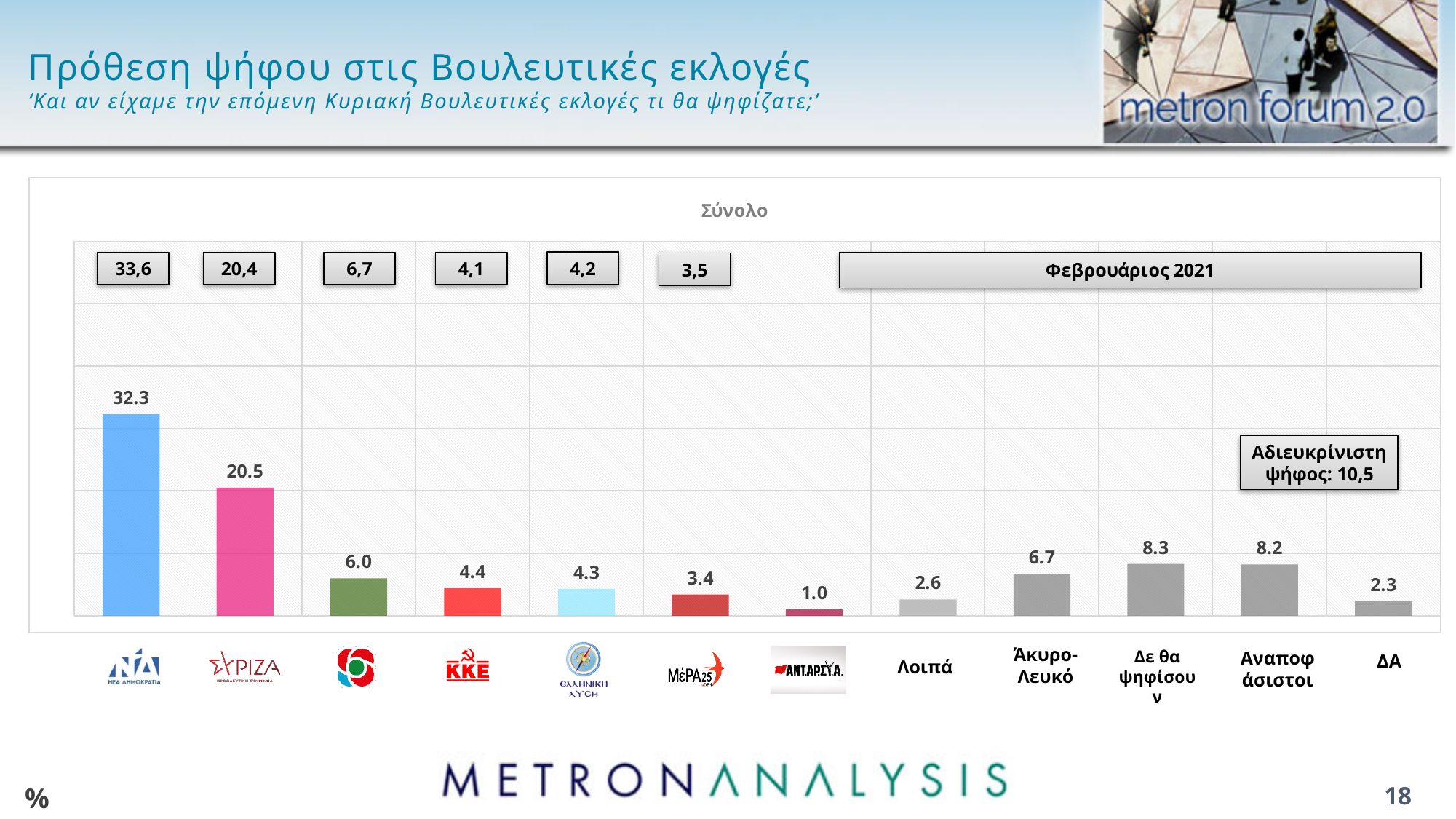
Which category has the lowest value? ΑΝΤΑΡΣΥΑ Which is larger, the value for Άκυρο-Λευκό or the value for Λοιπά? Άκυρο-Λευκό What kind of chart is shown on the slide? Bar chart How many bars are plotted in the chart? 12 What is the Φεβρουάριος 2021 value shown in the box above the ΝΕΑ ΔΗΜΟΚΡΑΤΙΑ bar? 33,6 What is the value for Άκυρο-Λευκό? 6.7 What is the difference between the values for ΝΕΑ ΔΗΜΟΚΡΑΤΙΑ and ΣΥΡΙΖΑ? 11.8 Which category has the highest value? ΝΕΑ ΔΗΜΟΚΡΑΤΙΑ What is the value for ΚΚΕ? 4.4 What is the value for ΔΑ? 2.3 What is the value for ΣΥΡΙΖΑ? 20.5 What is the value for Λοιπά? 2.6